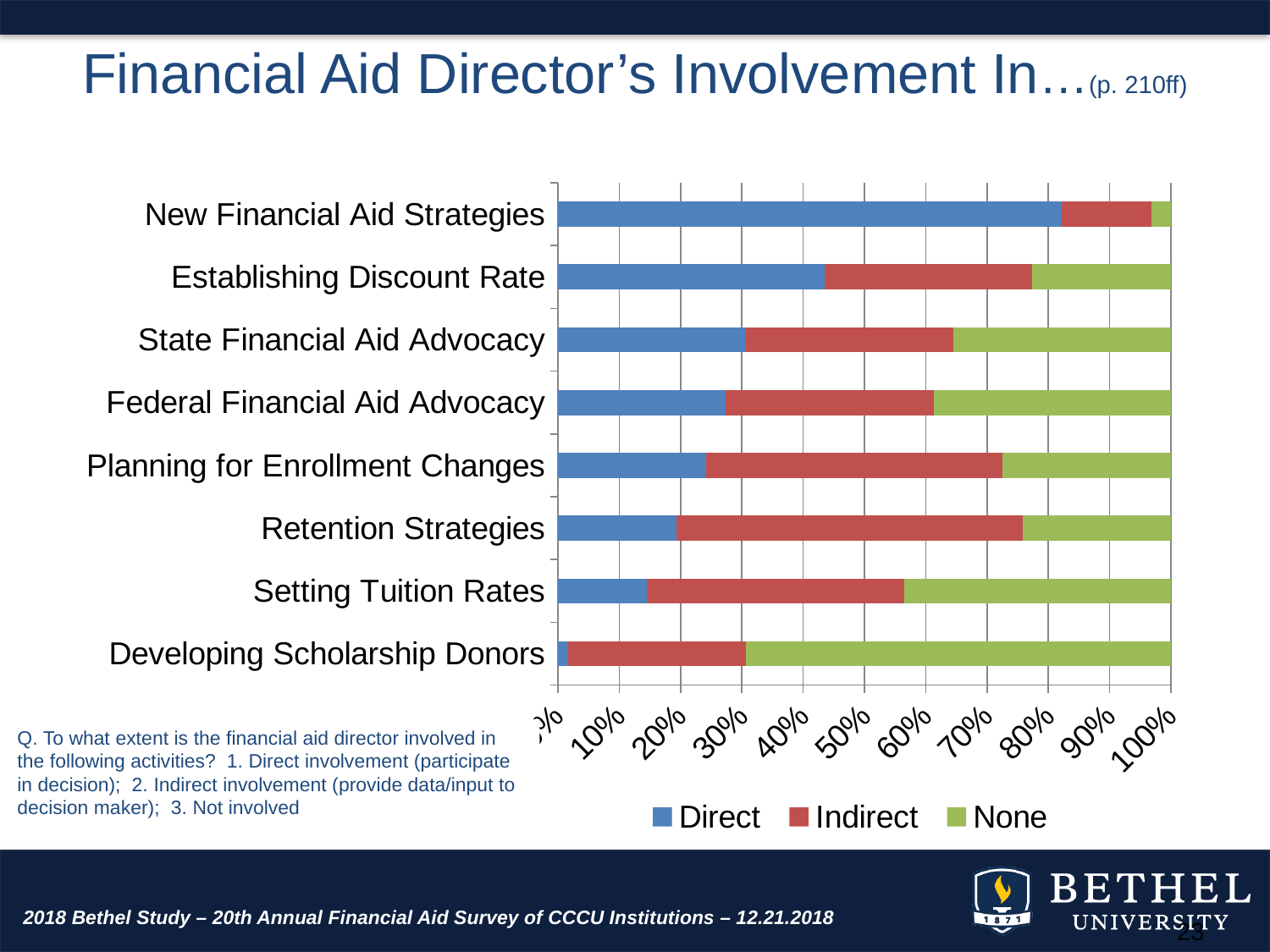
How many series does the legend list? 3 Is the Direct share for Setting Tuition Rates greater or less than 20%? less What colour represents the Indirect series in the legend? Red What kind of chart is shown on the slide? Stacked bar chart How many activities (categories) are plotted on the chart? 8 Which activity has the largest None share? Developing Scholarship Donors Is the Direct share for New Financial Aid Strategies greater or less than 70%? greater Which activity has the smallest Direct involvement share? Developing Scholarship Donors Which activity has the smallest None share? New Financial Aid Strategies Which is larger: the Direct share for Establishing Discount Rate or the Direct share for Retention Strategies? Establishing Discount Rate Is the None share for Developing Scholarship Donors greater or less than 60%? greater Which activity has the largest Direct involvement share? New Financial Aid Strategies